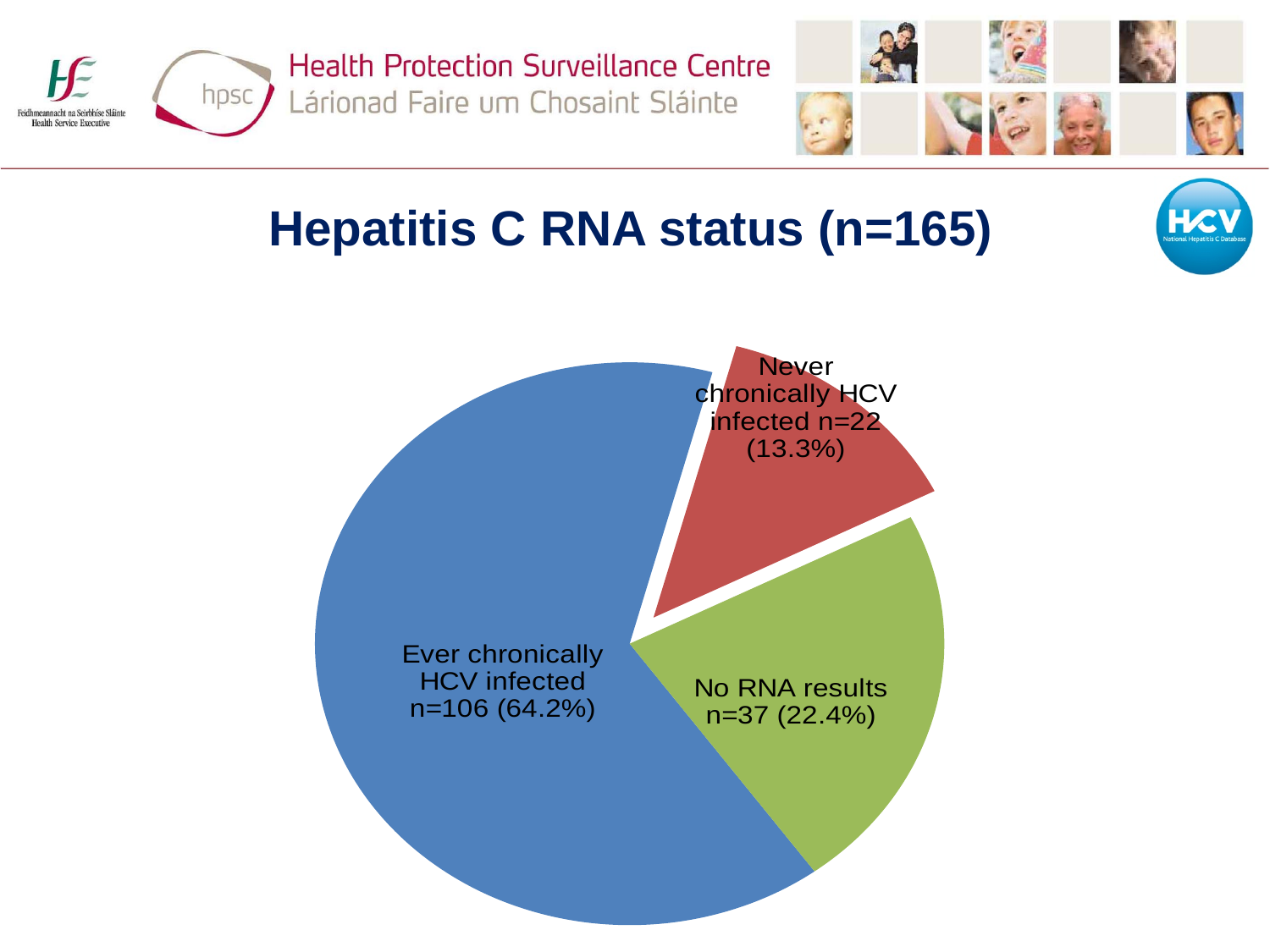
Which is larger: 'No RNA results' or 'Never chronically HCV infected'? No RNA results What type of chart is shown on the slide? pie chart What is the difference in count between 'Ever chronically HCV infected' and 'No RNA results'? 69 How many slices does the pie chart have? 3 How many people had no RNA results? 37 What percentage of the pie is 'No RNA results'? 22.4% What colour is the 'Never chronically HCV infected' slice? red What is the title of the chart? Hepatitis C RNA status (n=165) Which category has the largest slice? Ever chronically HCV infected How many people were ever chronically HCV infected? 106 Which category has the smallest slice? Never chronically HCV infected What percentage of the pie is 'Never chronically HCV infected'? 13.3%